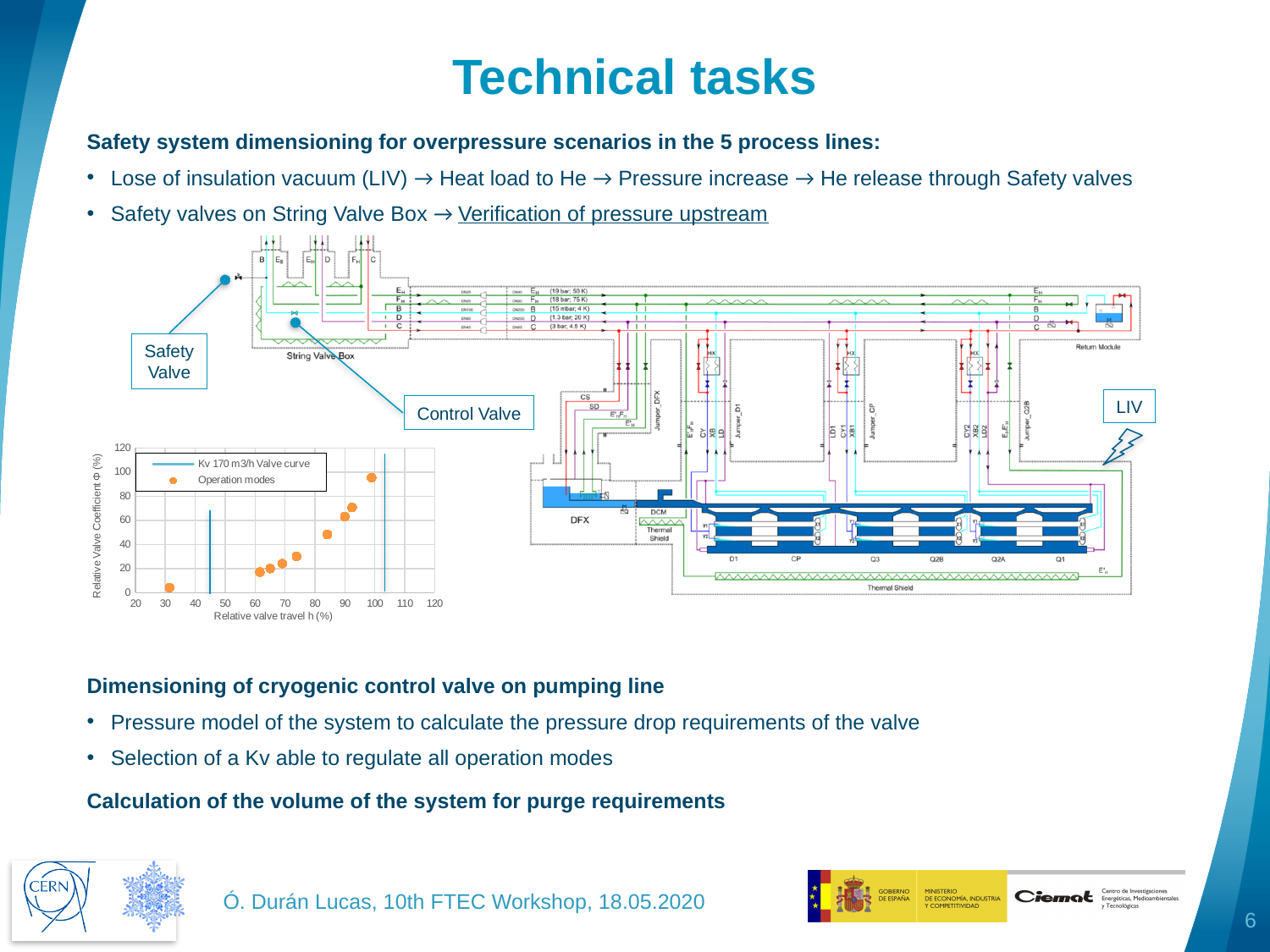
Is the relative valve travel of the lowest Operation modes point greater or less than 40? less How many series does the chart legend list? 2 Is the Relative Valve Coefficient of the lowest Operation modes point greater or less than 20? less Is the Relative Valve Coefficient of the highest Operation modes point greater or less than 80? greater What is the maximum value shown on the y axis of the chart? 120 What are the two entries in the chart legend? Kv 170 m3/h Valve curve; Operation modes What is the title of the x axis of the chart? Relative valve travel h (%) Do the Operation modes points rise or fall as relative valve travel increases? rise What kind of chart is shown on the slide? scatter chart